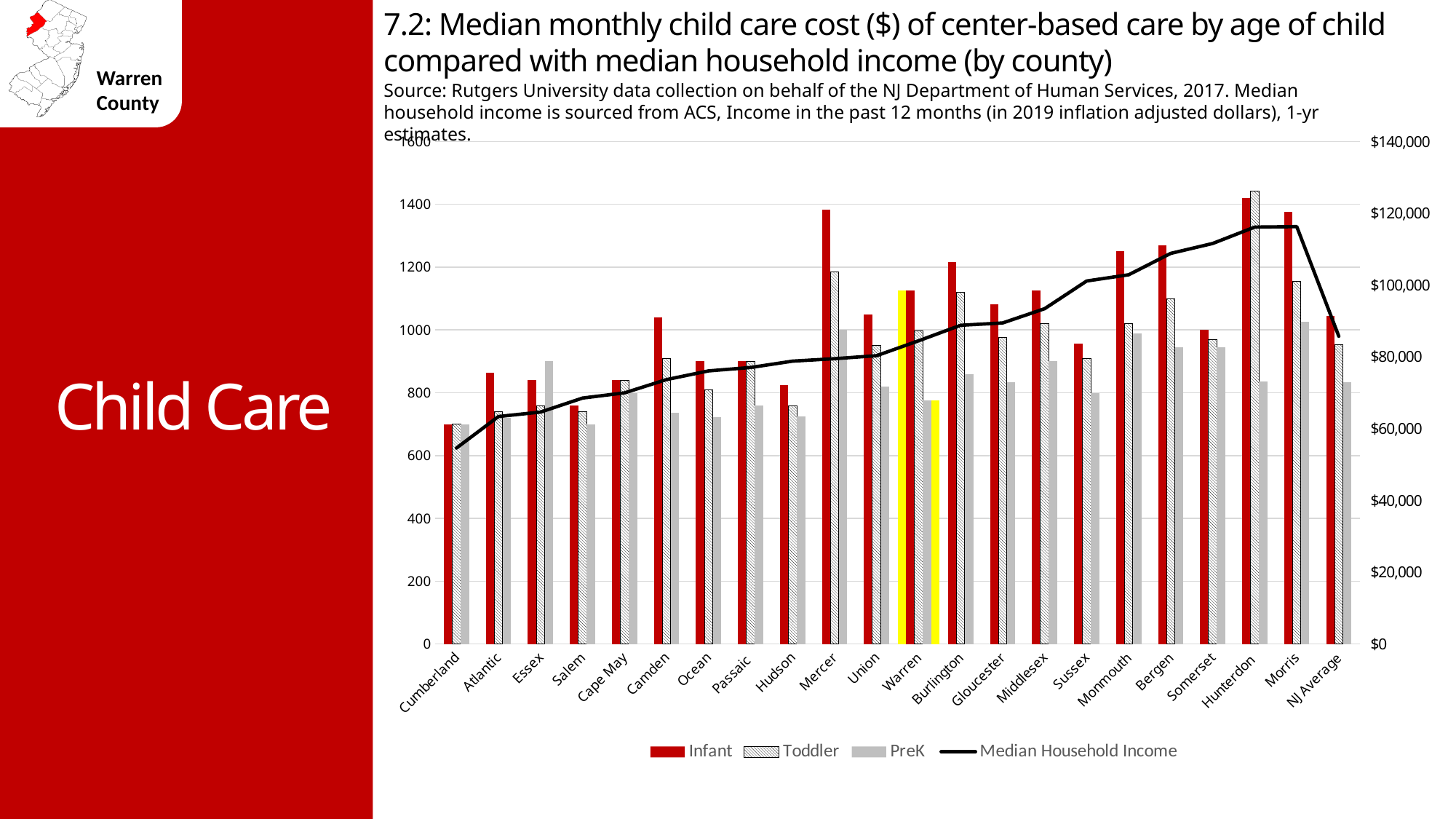
Which county's bars are highlighted in yellow? Warren Does the Median Household Income line generally rise or fall from Cumberland to Morris? rise Which is larger, the Infant value for Mercer or the Infant value for Warren? Mercer Is the Infant value for Cumberland greater or less than 800? less Is the Infant value for Mercer greater or less than 1200? greater Which county has the highest Toddler bar? Hunterdon How many series does the legend list? 4 How many categories are shown along the x axis? 22 Is the Median Household Income for Morris greater or less than $100,000? greater Which county has the highest Infant bar? Hunterdon Which county has the lowest Infant bar? Cumberland What kind of chart is shown on the slide? A bar chart with a line series